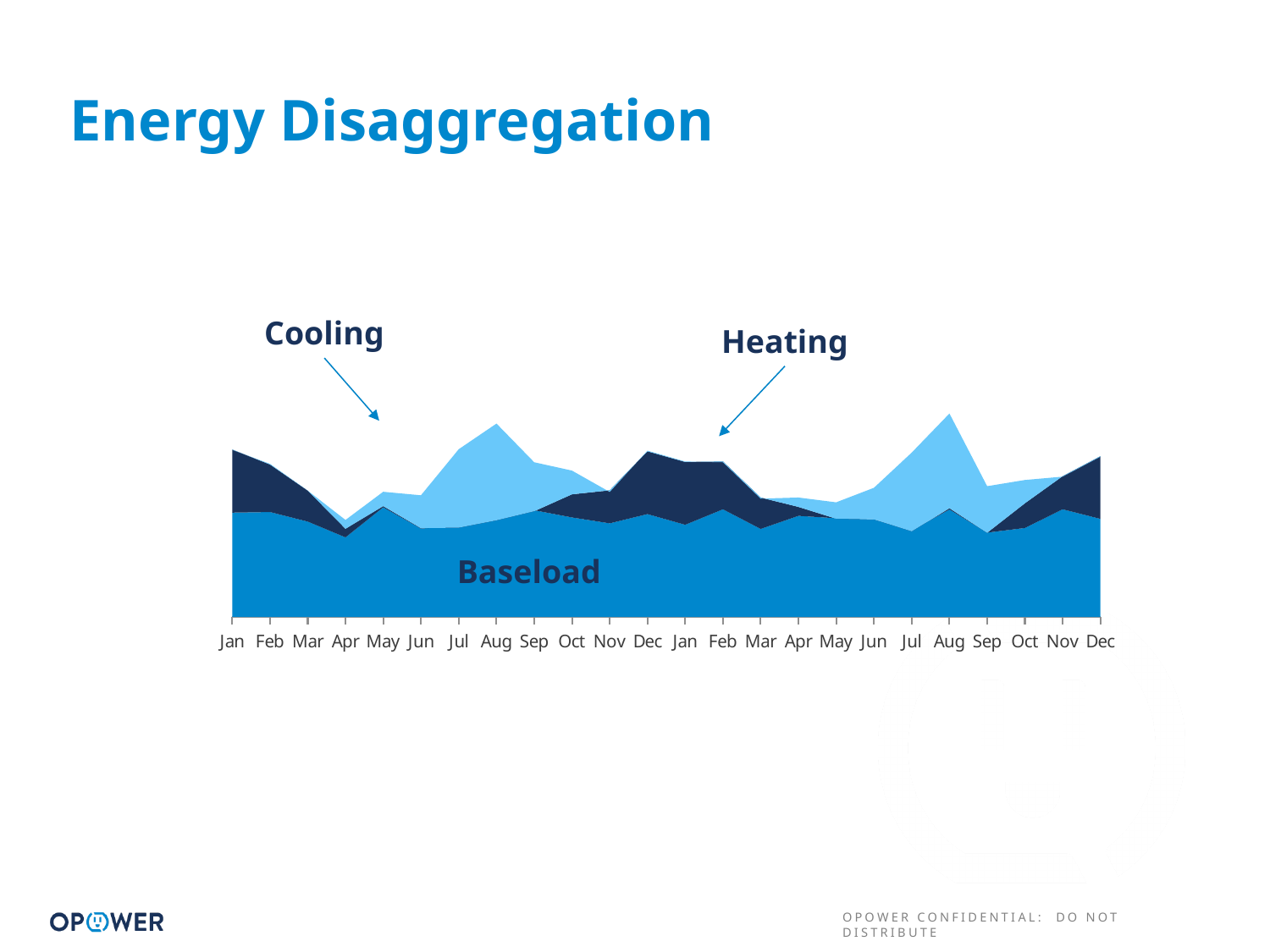
In which month does the Cooling component reach its highest peak? Aug Which energy component is shown as the light blue area? Cooling How many energy components are labelled on the chart? 3 What is the last month label on the x axis? Dec What are the three energy components labelled on the chart? Cooling, Heating, Baseload What kind of chart is shown on the slide? area chart How many months are labelled along the x axis of the chart? 24 In which month does the total stacked energy use reach its highest point? Aug Which energy component accounts for the largest portion of energy use across the whole period? Baseload What is the first month label on the x axis? Jan How many years of monthly data does the x axis cover? 2 Is the Cooling component larger in Aug or in Jan? Aug